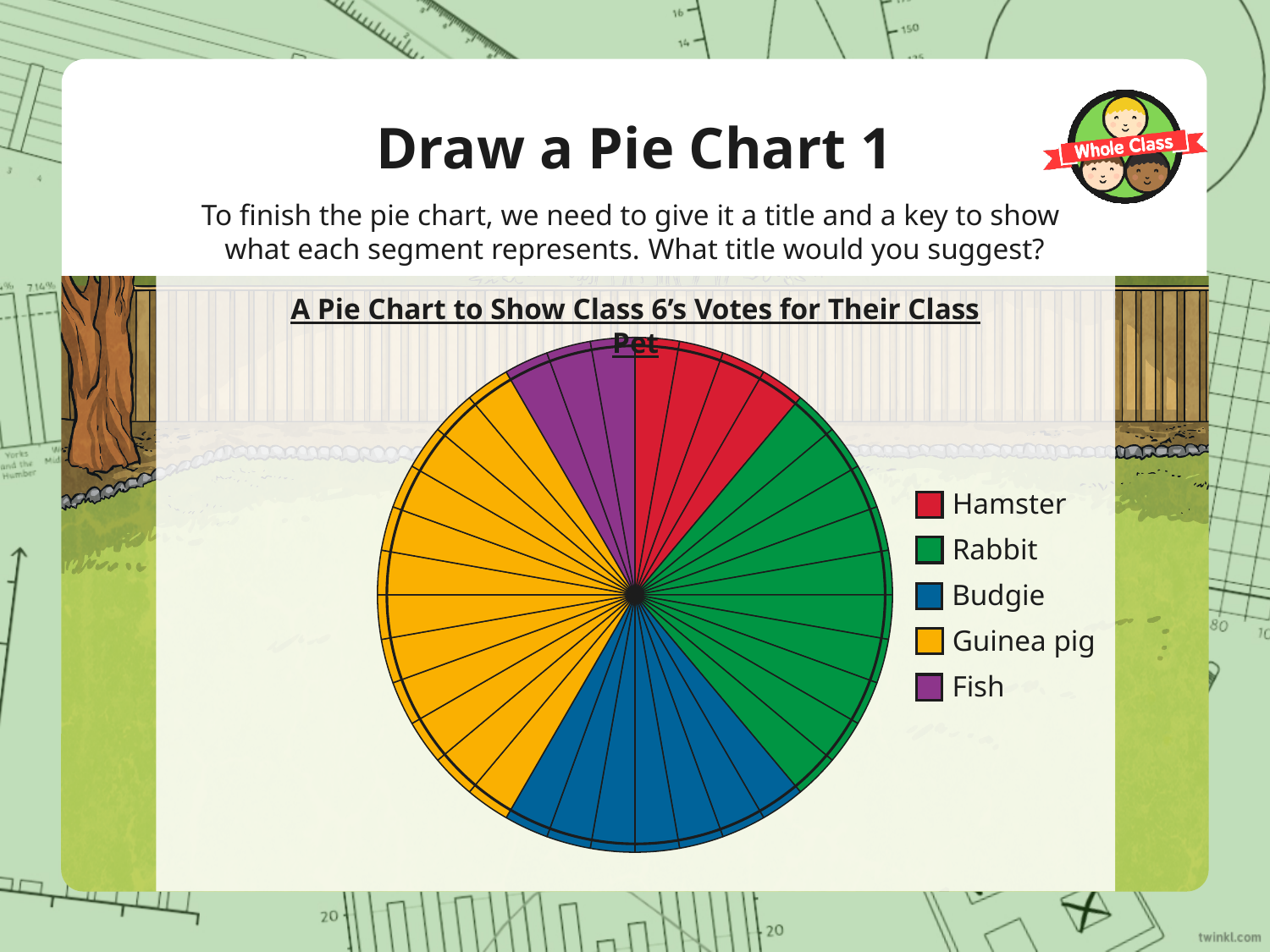
How many categories does the pie chart show? 5 Which colour represents Hamster in the pie chart? red How many entries does the legend of the pie chart list? 5 Which slice is larger in the pie chart, Budgie or Fish? Budgie Which slice is larger in the pie chart, Guinea pig or Fish? Guinea pig Which slice is larger in the pie chart, Guinea pig or Hamster? Guinea pig What kind of chart is shown on the slide? pie chart What is the title of the pie chart? A Pie Chart to Show Class 6's Votes for Their Class Pet